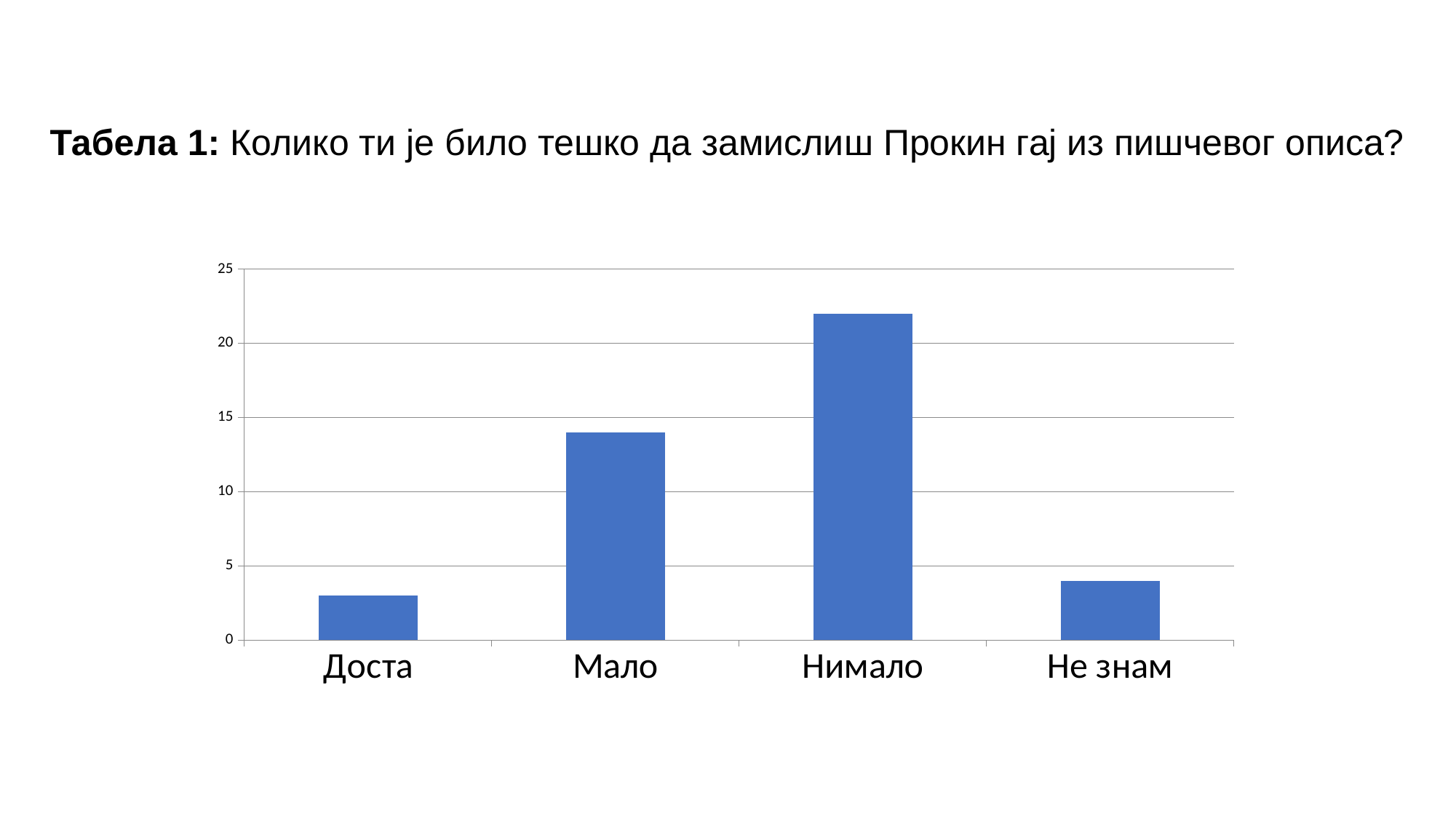
Is the value for Доста greater or less than 5? less What is the label of the first category on the x axis of the chart? Доста What kind of chart is shown on the slide? bar chart Which is larger, the value for Доста or the value for Мало? Мало What is the highest tick value shown on the vertical axis of the chart? 25 Is the value for Мало greater or less than 15? less How many categories are shown on the x axis of the chart? 4 Which category has the highest value in the chart? Нимало Is the value for Нимало greater or less than 20? greater Which is larger, the value for Мало or the value for Нимало? Нимало